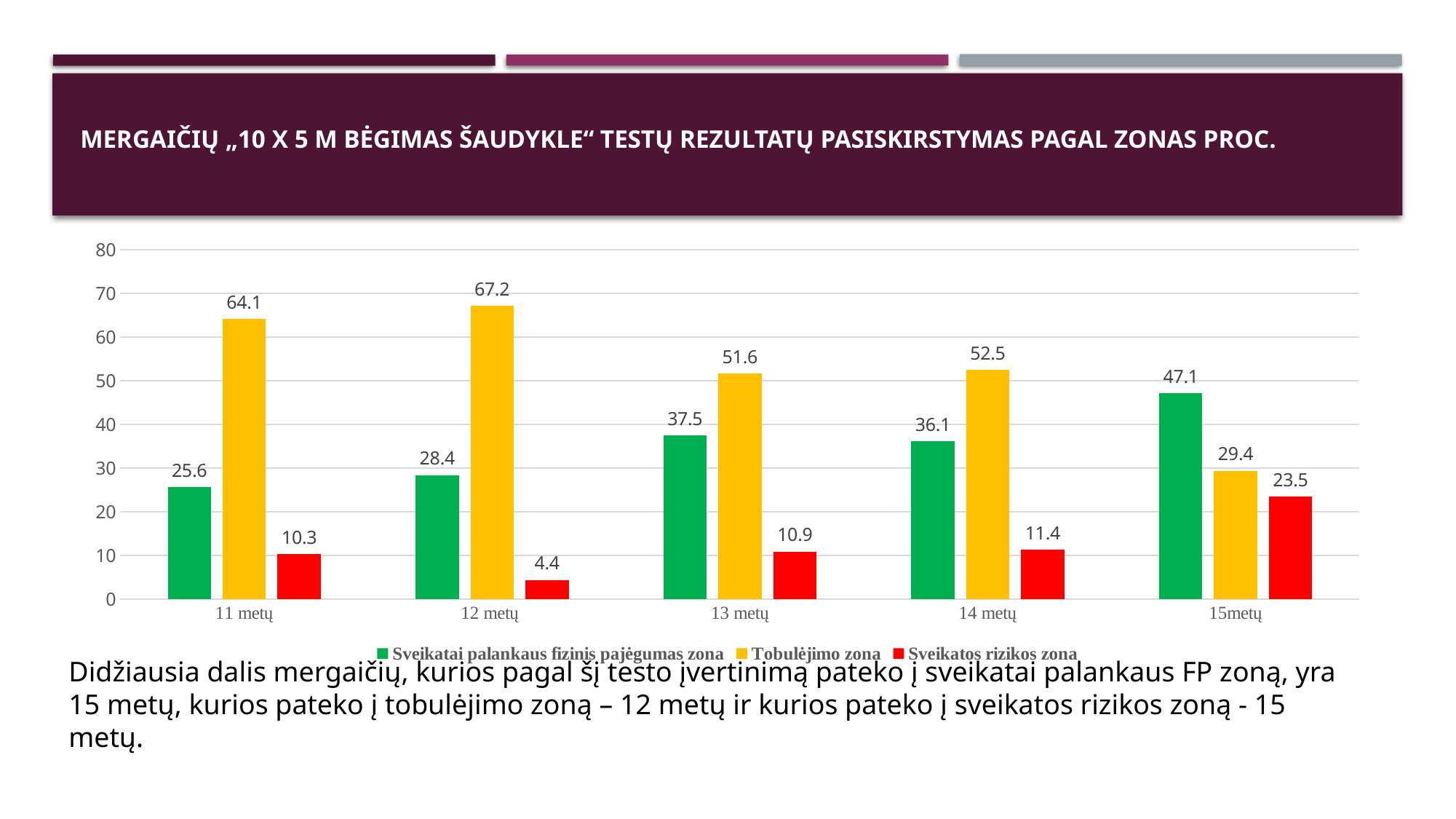
What is the difference between the "Tobulėjimo zona" values for 11 metų and 15metų? 34.7 What is the value for "Sveikatos rizikos zona" at 15metų? 23.5 What kind of chart is shown on the slide? Bar chart Which colour represents "Sveikatos rizikos zona" in the chart? Red How many series does the legend list? 3 What is the value for "Tobulėjimo zona" at 12 metų? 67.2 Which is larger at 14 metų: "Sveikatai palankaus fizinis pajėgumas zona" or "Tobulėjimo zona"? Tobulėjimo zona Which age group has the highest value for "Sveikatai palankaus fizinis pajėgumas zona"? 15metų How many age groups are shown on the x axis? 5 Do the values for "Sveikatai palankaus fizinis pajėgumas zona" rise or fall from 11 metų to 15metų? Rise What is the value for "Sveikatai palankaus fizinis pajėgumas zona" at 13 metų? 37.5 Which age group has the lowest value for "Sveikatos rizikos zona"? 12 metų